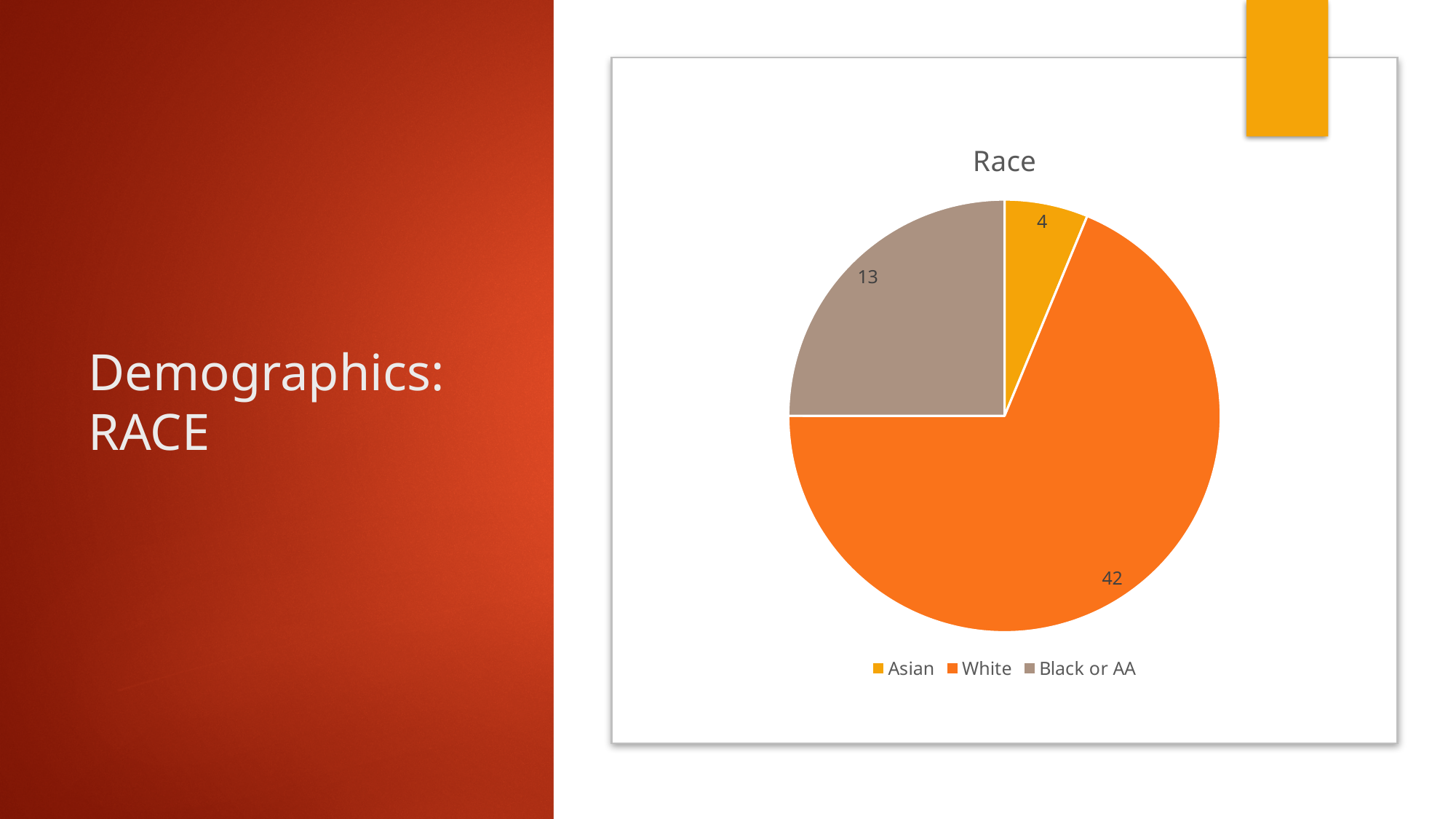
What is the title of the chart on the slide? Race What is the difference between the White and Black or AA values in the Race pie chart? 29 Which is larger in the Race pie chart, Black or AA or Asian? Black or AA What kind of chart is shown on the slide? Pie chart What is the value for Asian in the Race pie chart? 4 Which category has the smallest slice in the Race pie chart? Asian What is the total of all slices in the Race pie chart? 59 What is the value for Black or AA in the Race pie chart? 13 What is the difference between the Black or AA and Asian values in the Race pie chart? 9 What is the value for White in the Race pie chart? 42 How many categories are shown in the Race pie chart? 3 Which category has the largest slice in the Race pie chart? White